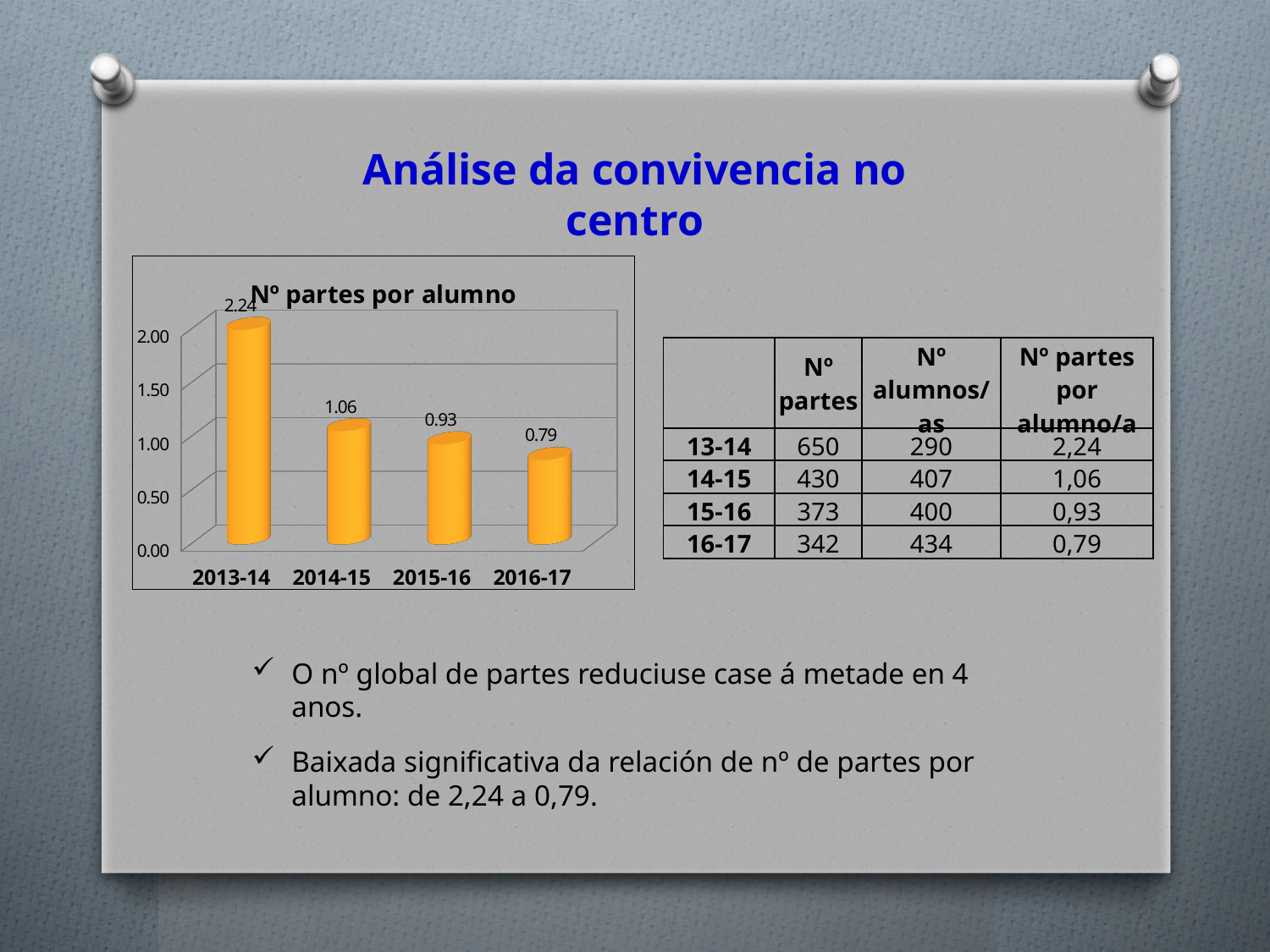
What kind of chart is shown on the slide? bar chart Is the value for 2013-14 greater or less than 2.00? greater Which year has the highest value in the chart? 2013-14 What is the value for 2014-15 in the chart? 1.06 What is the difference between the values for 2013-14 and 2016-17? 1.45 What is the value for 2015-16 in the chart? 0.93 Which year has the lowest value in the chart? 2016-17 What is the value for 2016-17 in the chart? 0.79 Do the values rise or fall from 2013-14 to 2016-17? fall What is the value for 2013-14 in the chart? 2.24 How many years are shown on the x axis of the chart? 4 Which is larger, the value for 2014-15 or the value for 2015-16? 2014-15